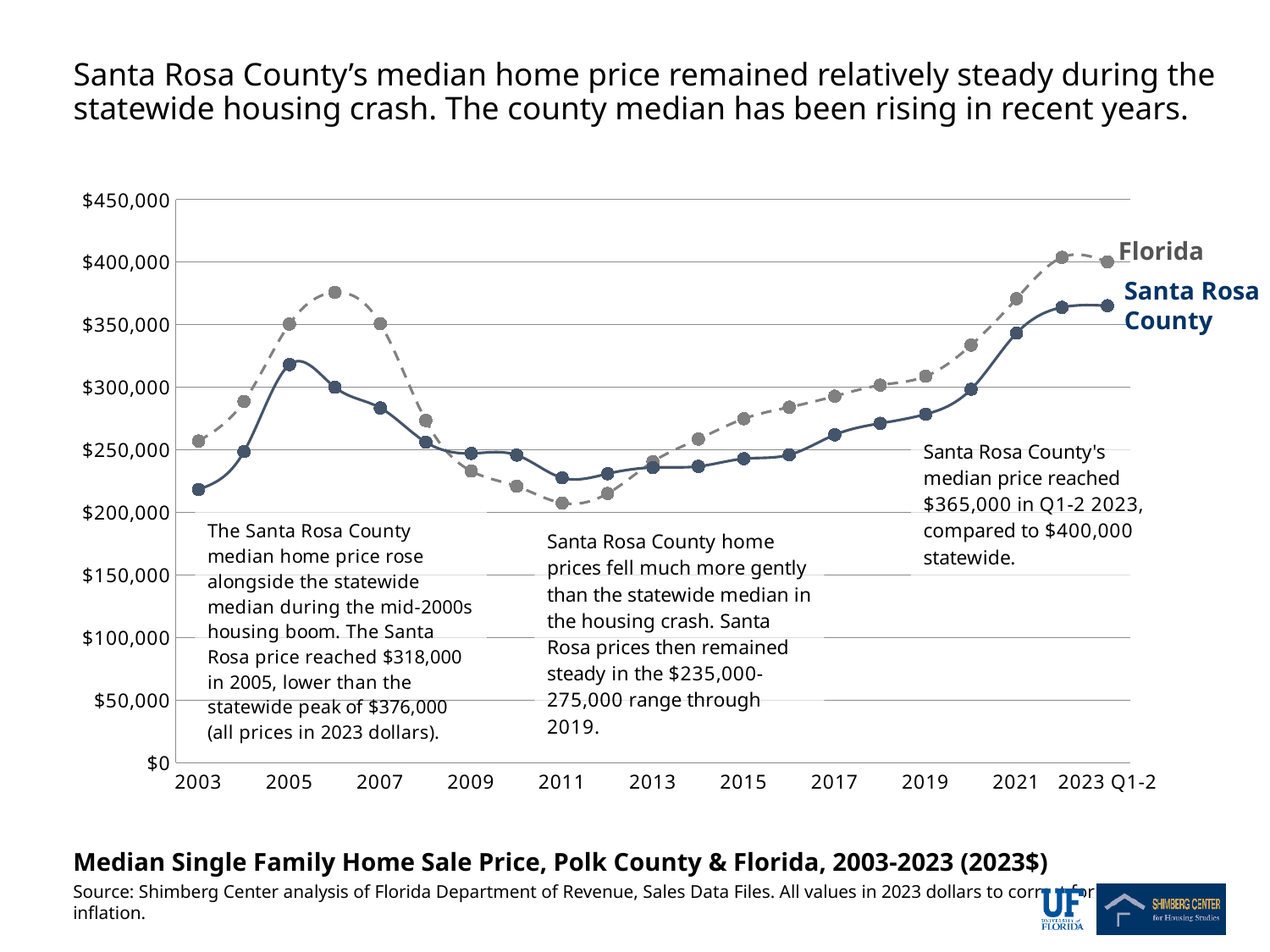
What was the statewide (Florida) median price in Q1-2 2023? $400,000 What was the Santa Rosa County median price in Q1-2 2023? $365,000 Does the Santa Rosa County line rise or fall from 2019 to 2023 Q1-2? rise Which series is drawn with a dashed line? Florida In Q1-2 2023, which series has the higher median price, Florida or Santa Rosa County? Florida Is the Florida value for 2011 greater or less than $250,000? less How many series are plotted on the chart? 2 What kind of chart is shown on the slide? line chart What was the Santa Rosa County median home price in 2005, according to the chart annotation? $318,000 How much higher was the statewide peak of $376,000 than the Santa Rosa County 2005 peak of $318,000? $58,000 Is the Santa Rosa County value for 2003 greater or less than $250,000? less What is the difference between the Florida and Santa Rosa County median prices in Q1-2 2023? $35,000